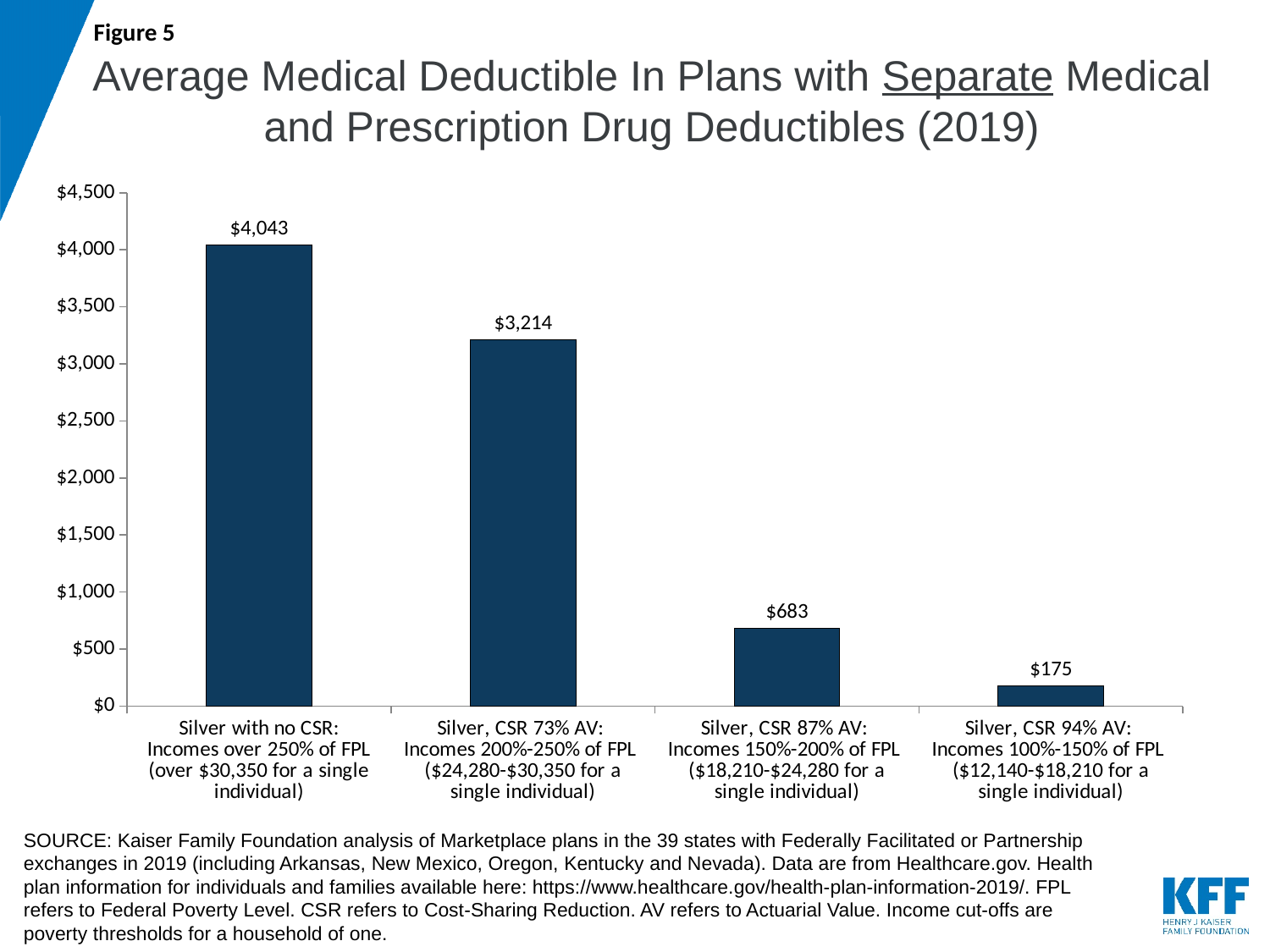
Which plan category has the lowest average medical deductible? Silver, CSR 94% AV What is the average medical deductible for Silver plans with no CSR? $4,043 Which plan category has the highest average medical deductible? Silver with no CSR What is the difference between the average medical deductible for Silver, CSR 87% AV and Silver, CSR 94% AV? $508 Do the average medical deductibles rise or fall moving from left to right across the categories? Fall Which has a larger average medical deductible: Silver, CSR 73% AV or Silver, CSR 87% AV? Silver, CSR 73% AV What is the average medical deductible for Silver, CSR 87% AV plans? $683 What is the average medical deductible for Silver, CSR 73% AV plans? $3,214 How many plan categories are shown in the chart? 4 What kind of chart is shown on the slide? Bar chart What is the difference between the average medical deductible for Silver with no CSR and Silver, CSR 73% AV? $829 What is the average medical deductible for Silver, CSR 94% AV plans? $175